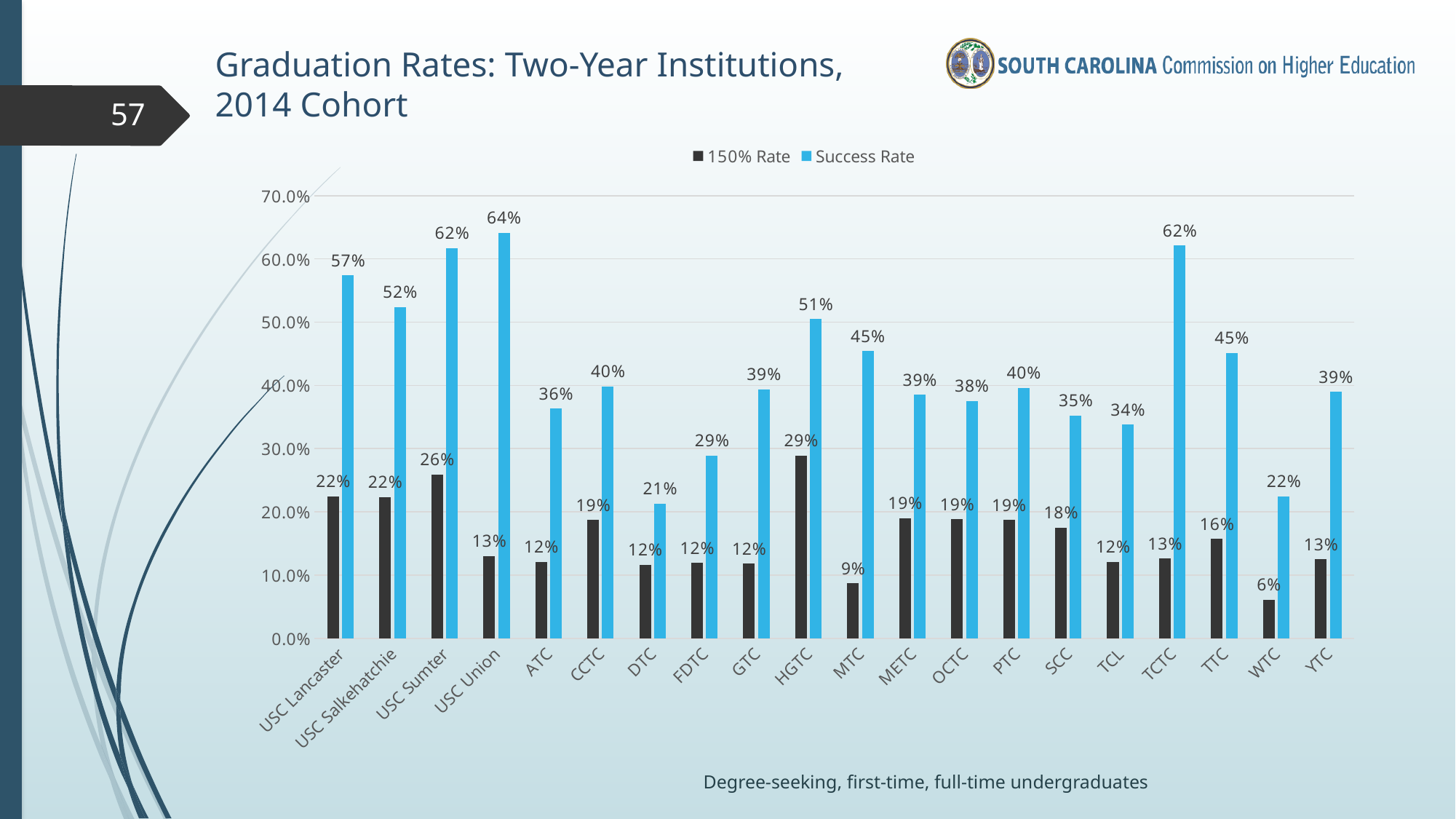
What kind of chart is shown on the slide? Bar chart Is the Success Rate for HGTC greater or less than 50.0%? greater What is the Success Rate for USC Union? 64% Which institution has the highest Success Rate? USC Union What is the Success Rate for DTC? 21% What is the difference between the Success Rate and the 150% Rate for TCTC? 49% Which institution has the lowest 150% Rate? WTC How many institutions are shown on the x axis? 20 Which is larger, the Success Rate for MTC or the Success Rate for SCC? MTC How many series does the legend list? 2 Which institution has the lowest Success Rate? DTC What is the 150% Rate for HGTC? 29%